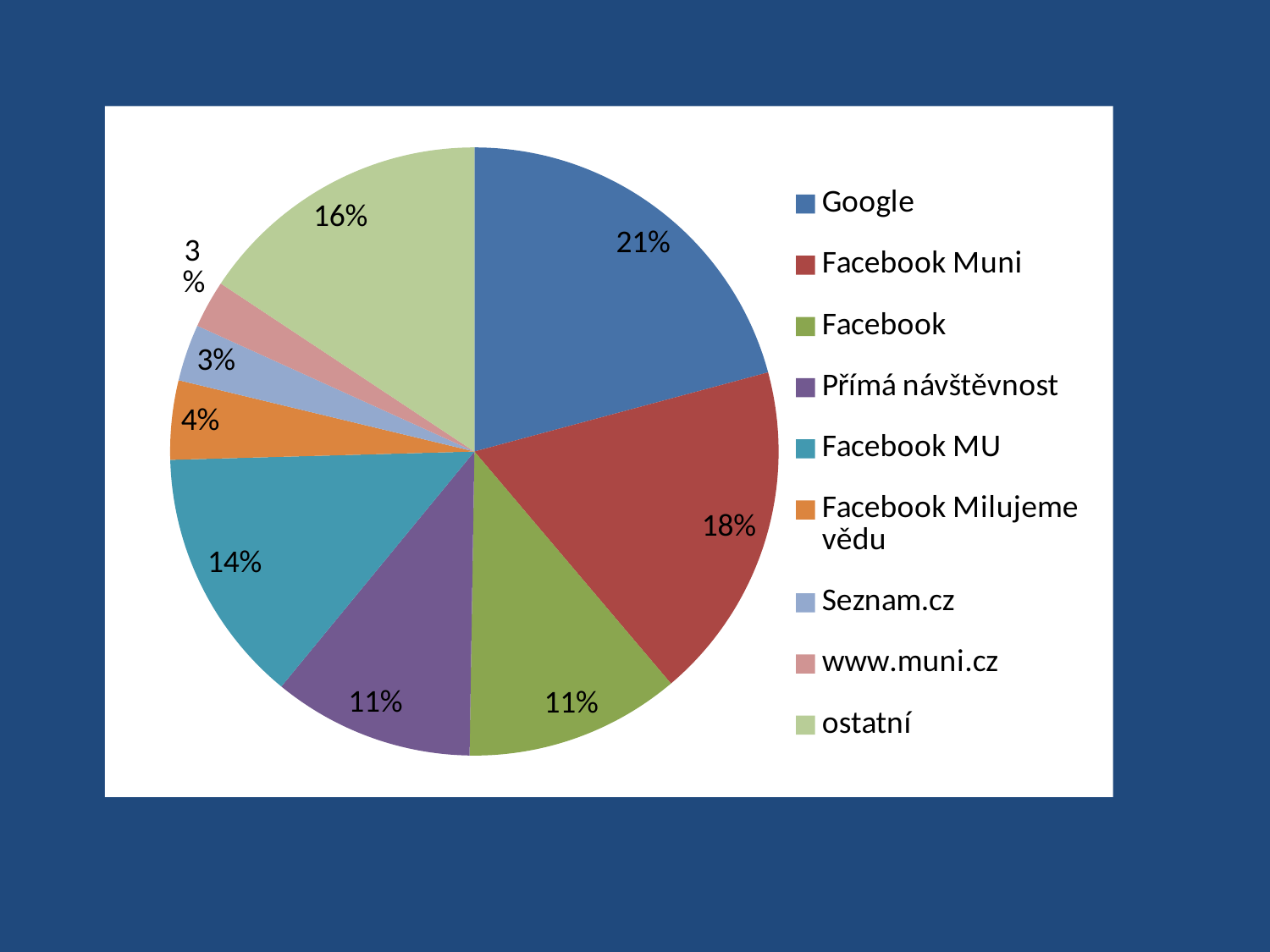
Which category has the largest slice of the pie? Google What is the difference between the Google share and the Facebook Muni share? 3% What percentage is shown for Facebook MU? 14% What is the value for ostatní? 16% Which is larger, the share for Facebook MU or the share for ostatní? ostatní What share of the pie does Google have? 21% What is the value for Přímá návštěvnost? 11% What percentage is shown for Facebook Milujeme vědu? 4% What kind of chart is shown on the slide? Pie chart What is the value shown for Facebook Muni? 18% How many categories does the pie chart show? 9 Which legend entry is shown in orange? Facebook Milujeme vědu